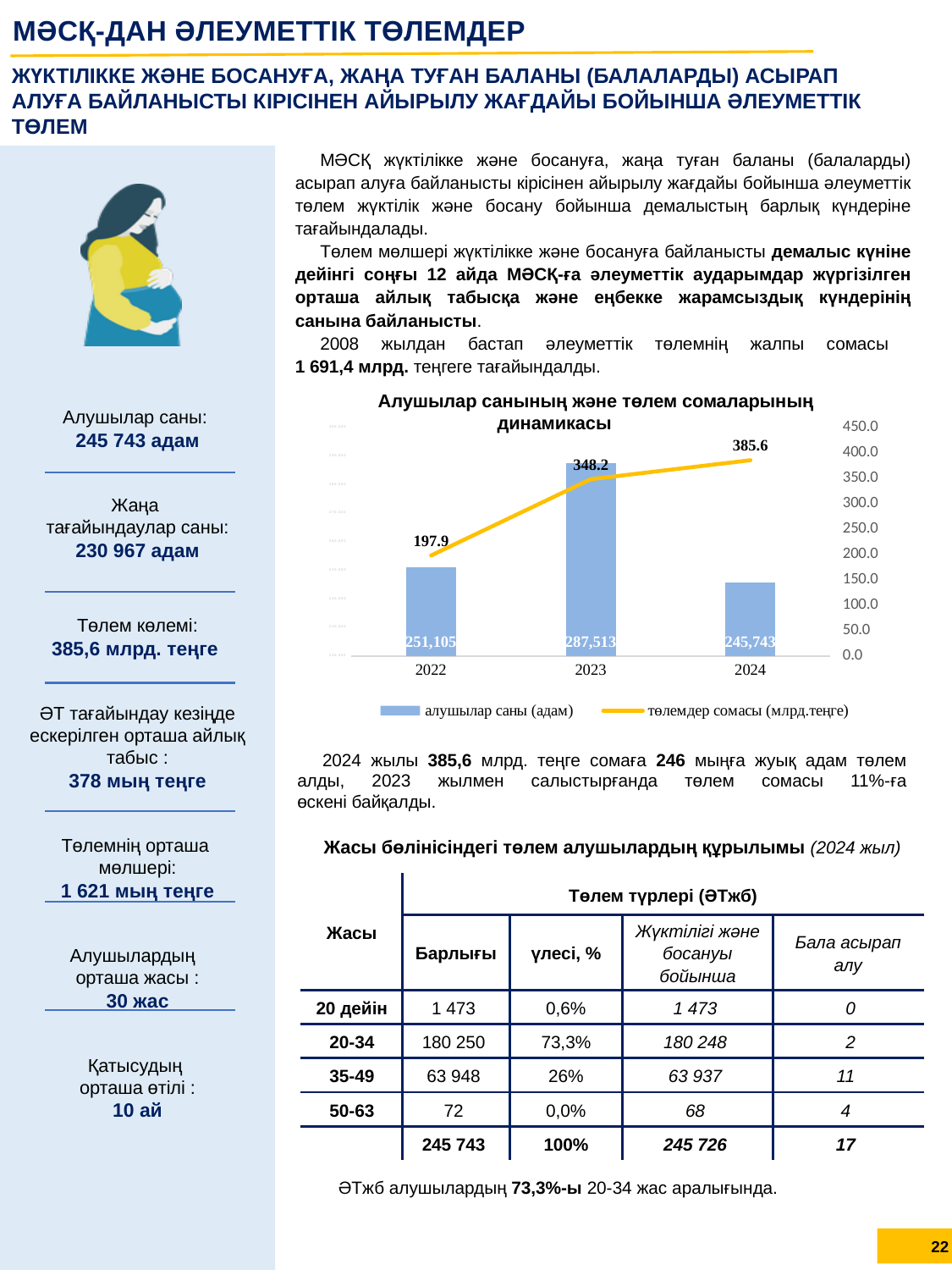
What is the difference between the 'алушылар саны (адам)' values for 2023 and 2022? 36,408 Which year has a larger 'алушылар саны (адам)' value, 2022 or 2024? 2022 Which year has the lowest value for 'төлемдер сомасы (млрд.теңге)'? 2022 How many series does the chart legend list? 2 What is the value of the 'алушылар саны (адам)' series for 2023? 287,513 What is the value of the 'төлемдер сомасы (млрд.теңге)' series for 2024? 385.6 What kind of chart is shown on the slide? Combined bar and line chart Does the 'төлемдер сомасы (млрд.теңге)' series rise or fall from 2022 to 2024? Rise Which year has the highest value for 'алушылар саны (адам)'? 2023 What is the difference between the 'төлемдер сомасы (млрд.теңге)' values for 2024 and 2023? 37.4 What is the value of the 'төлемдер сомасы (млрд.теңге)' series for 2022? 197.9 How many years are shown on the x axis of the chart? 3